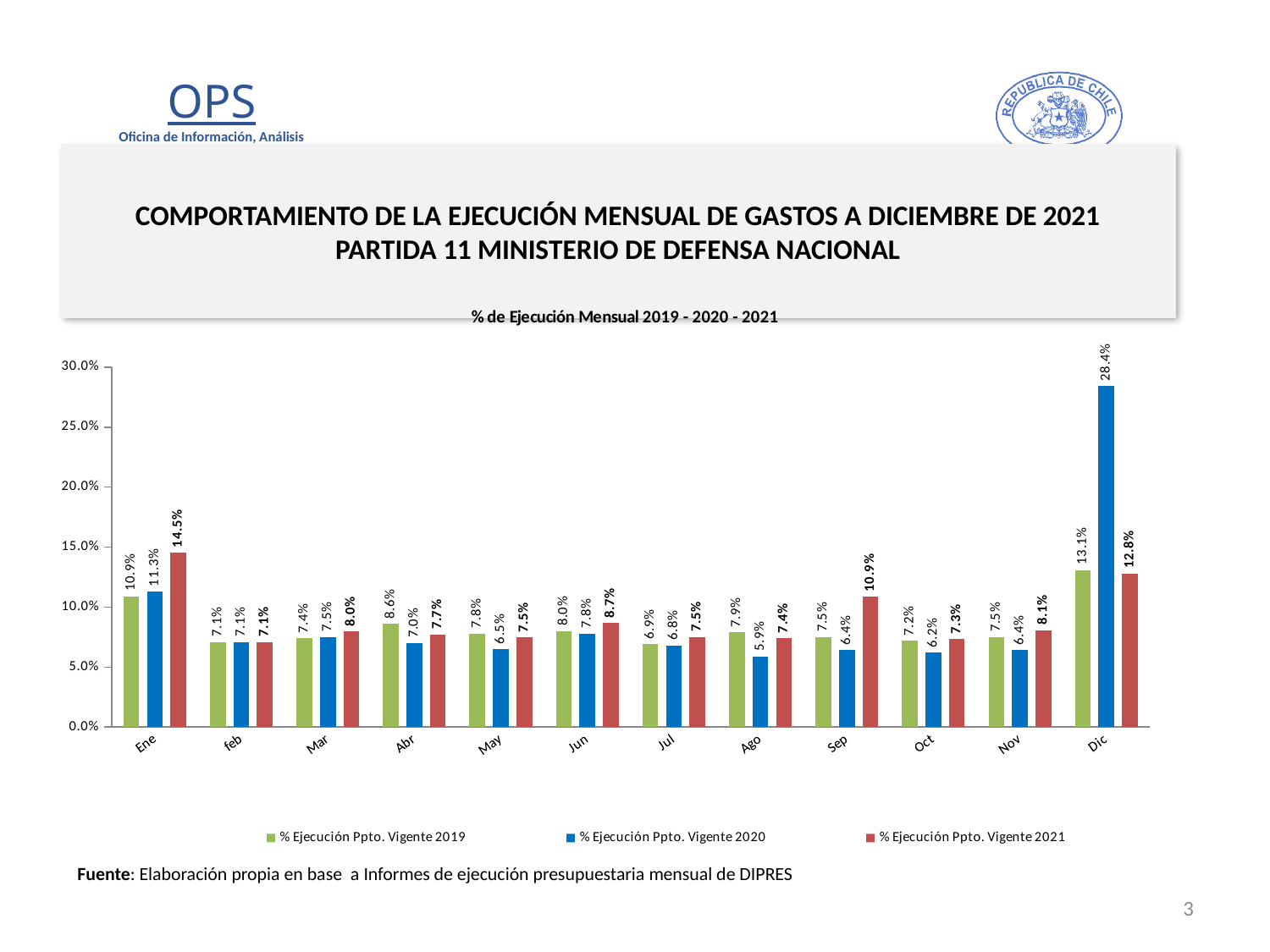
Which is larger for Abr: the 2019 value or the 2020 value? 2019 value (8.6%) Which month has the highest value in the % Ejecución Ppto. Vigente 2019 series? Dic What kind of chart is shown on the slide? Bar chart How many series does the legend list? 3 What is the value for Sep in the % Ejecución Ppto. Vigente 2021 series? 10.9% How many months are shown on the x axis? 12 What is the difference between the 2020 and 2021 values for Dic? 15.6% What is the value for Ene in the % Ejecución Ppto. Vigente 2021 series? 14.5% What is the value for Ago in the % Ejecución Ppto. Vigente 2020 series? 5.9% Which month has the lowest value in the % Ejecución Ppto. Vigente 2020 series? Ago What is the value for Dic in the % Ejecución Ppto. Vigente 2020 series? 28.4% Is the value for Dic in the 2020 series greater or less than 25.0%? greater